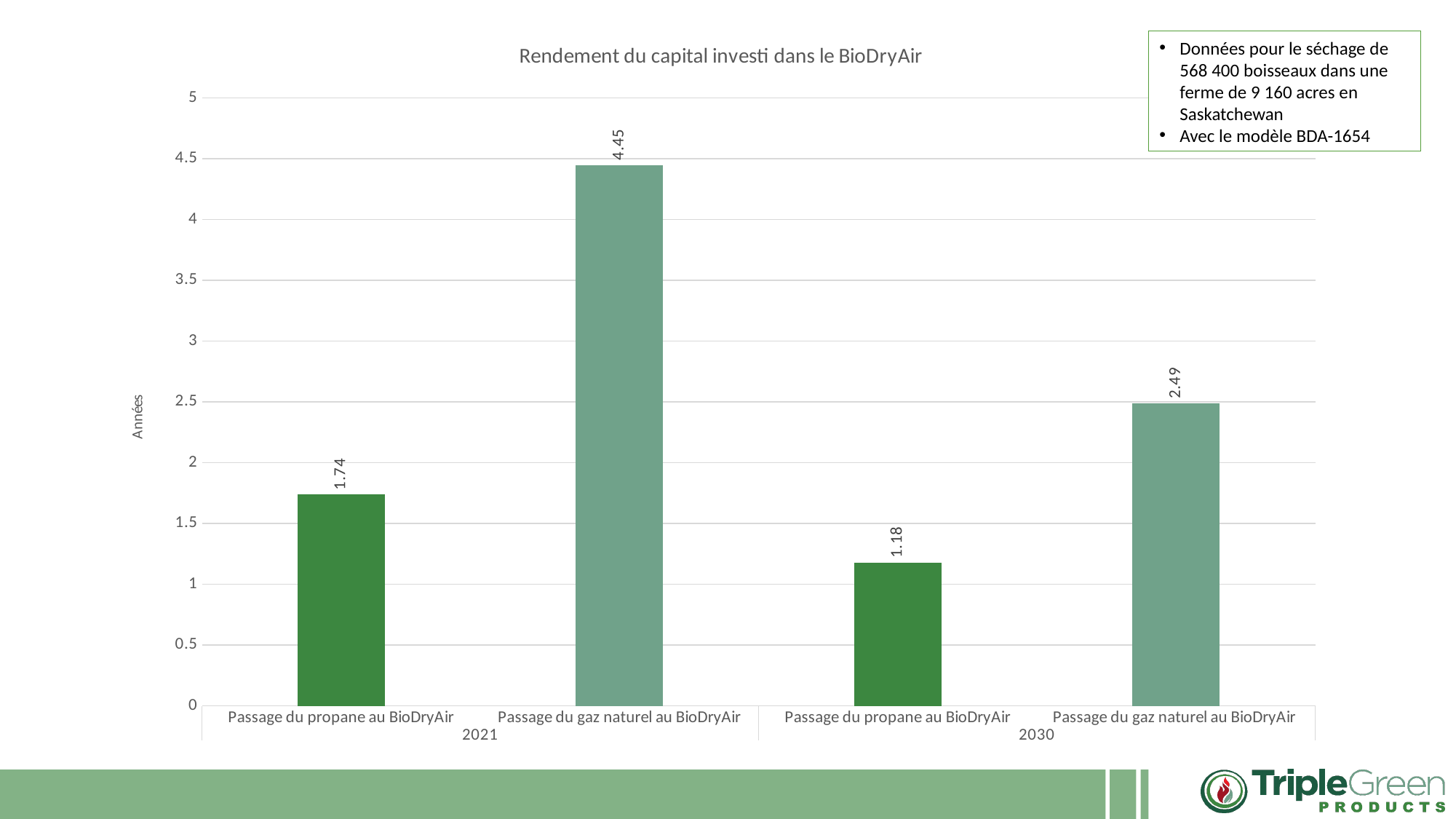
What is the value for 'Passage du gaz naturel au BioDryAir' in 2021? 4.45 What is the difference between the 2021 and 2030 values for 'Passage du propane au BioDryAir'? 0.56 What is the value for 'Passage du gaz naturel au BioDryAir' in 2030? 2.49 How many bars are plotted in the chart? 4 Which bar has the lowest value? Passage du propane au BioDryAir (2030) Which is larger: 'Passage du propane au BioDryAir' in 2021 or 'Passage du gaz naturel au BioDryAir' in 2030? Passage du gaz naturel au BioDryAir in 2030 What kind of chart is shown on the slide? Bar chart Which bar has the highest value? Passage du gaz naturel au BioDryAir (2021) What is the difference between the 2021 and 2030 values for 'Passage du gaz naturel au BioDryAir'? 1.96 What is the value for 'Passage du propane au BioDryAir' in 2021? 1.74 What is the value for 'Passage du propane au BioDryAir' in 2030? 1.18 What is the title of the chart? Rendement du capital investi dans le BioDryAir